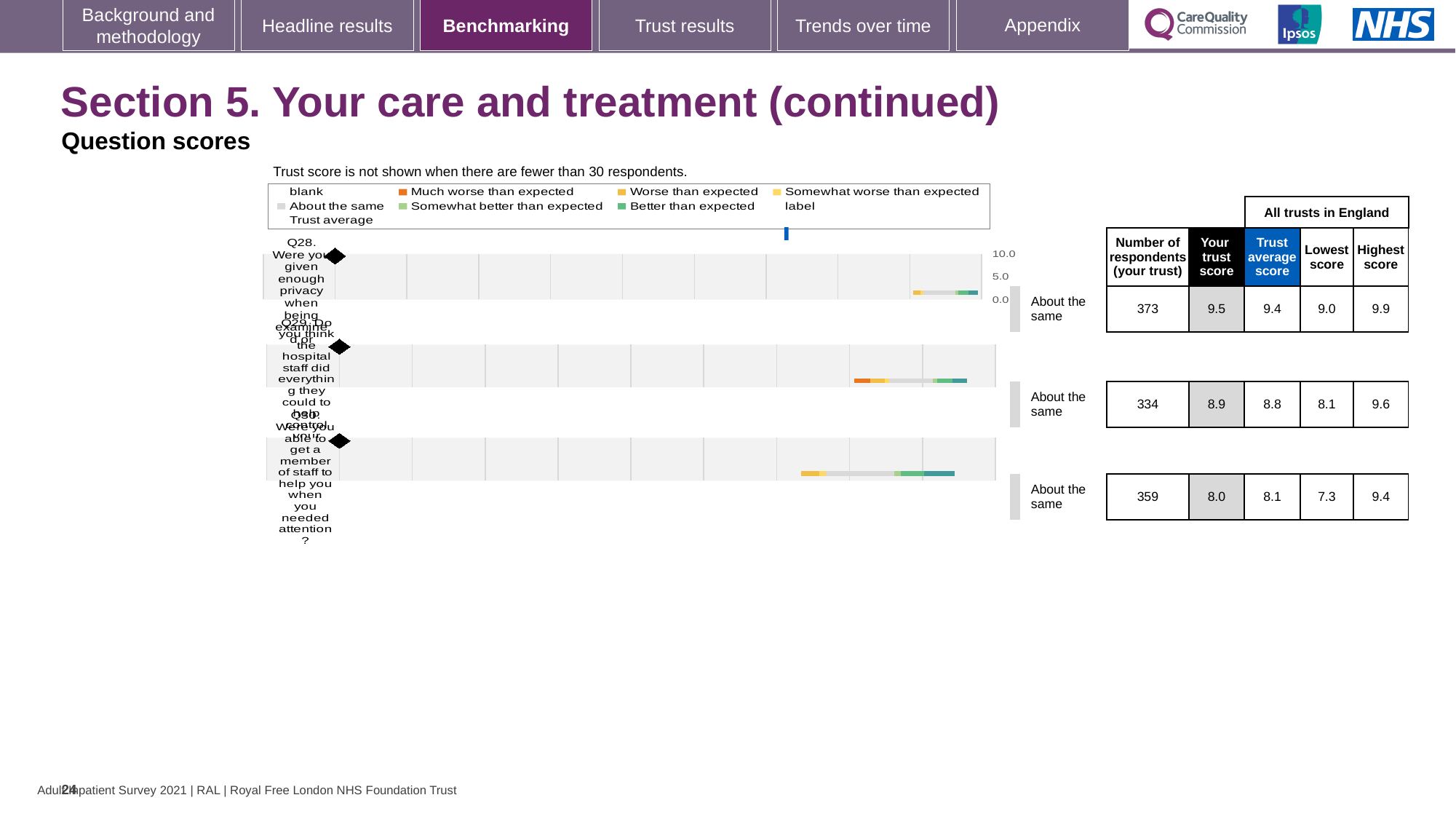
How many questions are plotted on the chart? 3 How many respondents from the trust answered Q30 (Were you able to get a member of staff to help you when you needed attention?)? 359 What type of chart is used to show the question scores? bar chart Which question has the highest trust score for this trust? Q28 What is the trust score for Q28 (Were you given enough privacy when being examined or treated?)? 9.5 What is the lowest score across all trusts in England for Q28? 9.0 What is the difference between the trust score and the trust average score for Q28? 0.1 What is the maximum value shown on the chart's score axis? 10.0 Which question has the lowest trust score for this trust? Q30 Is the trust score for Q29 higher or lower than the trust average score for Q29? higher What is the highest score across all trusts in England for Q30? 9.4 What is the trust average score for Q29 (Do you think the hospital staff did everything they could to help control your pain?)? 8.8